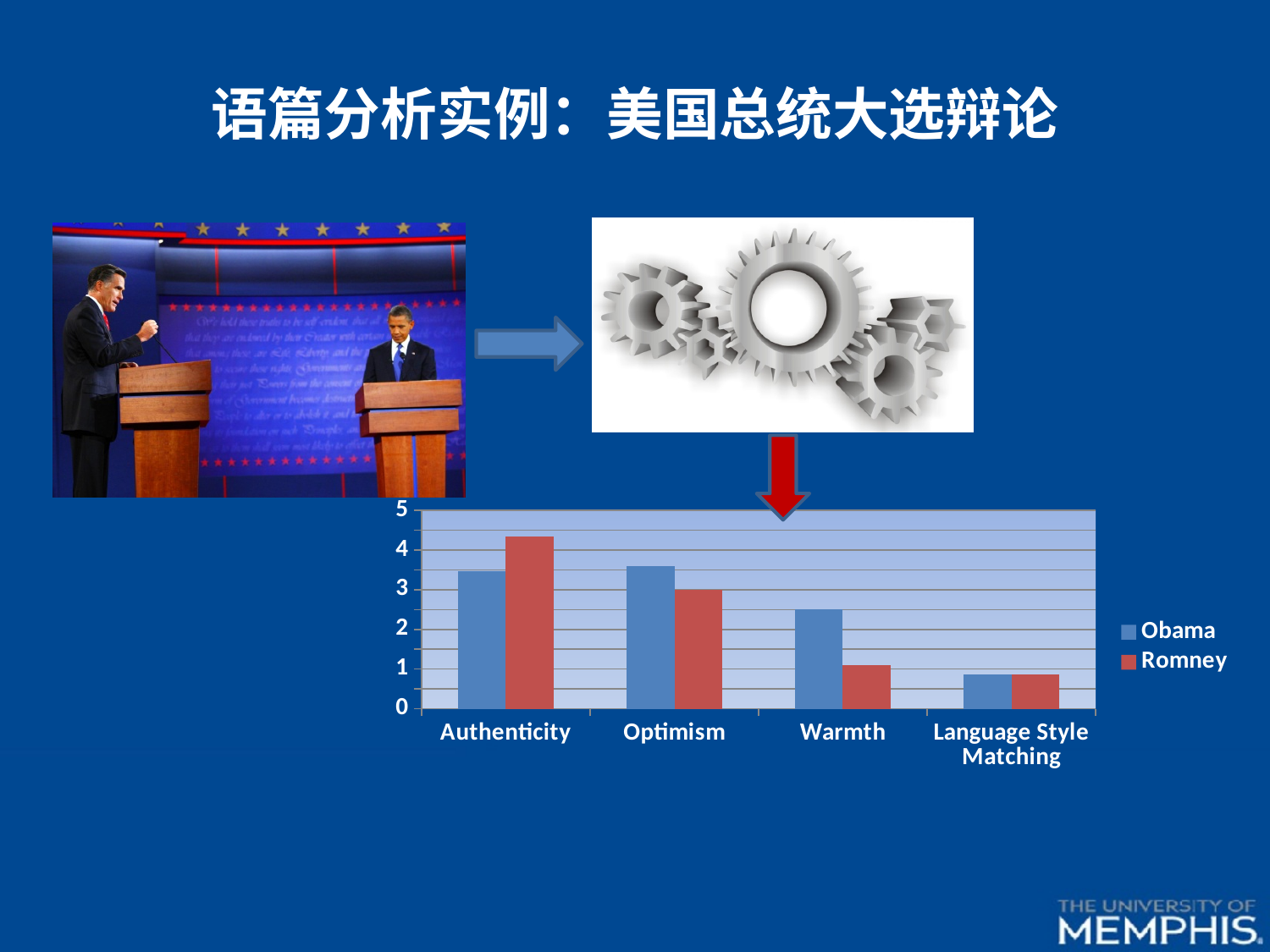
For Optimism, which is larger, the Obama bar or the Romney bar? Obama Which series is shown in red in the chart? Romney For Authenticity, which is larger, the Obama bar or the Romney bar? Romney Is the Romney value for Authenticity greater or less than 4? greater What kind of chart is shown on the slide? bar chart In which category is the Obama bar lowest? Language Style Matching How many categories are shown on the x axis of the chart? 4 In which category is the Romney bar highest? Authenticity For Warmth, which is larger, the Obama bar or the Romney bar? Obama Is the Romney value for Warmth greater or less than 2? less Is the Obama value for Language Style Matching greater or less than 1? less How many series does the chart's legend list? 2